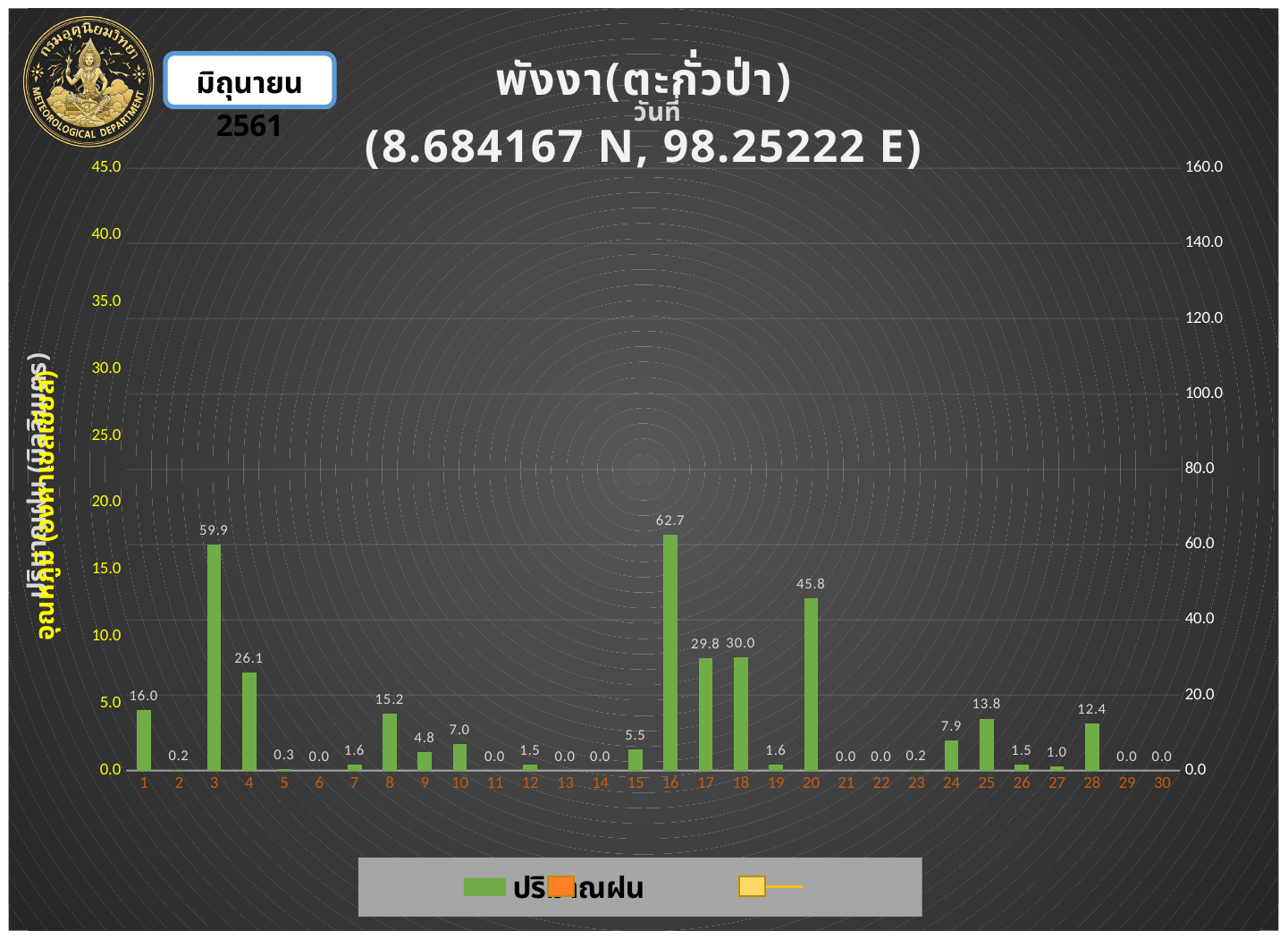
What is the difference between the rainfall values for day 4 and day 1? 10.1 Which day has the larger rainfall value, day 17 or day 18? 18 What is the rainfall value shown for day 28? 12.4 What kind of chart is shown on the slide? bar chart Which day has the larger rainfall value, day 8 or day 25? 8 Which day has the highest rainfall value? 16 What is the rainfall value shown for day 20? 45.8 What station name is given in the chart title? พังงา(ตะกั่วป่า) What is the rainfall value shown for day 16? 62.7 What is the rainfall value shown for day 3? 59.9 How many days are shown on the x axis of the chart? 30 What is the difference between the rainfall values for day 16 and day 3? 2.8